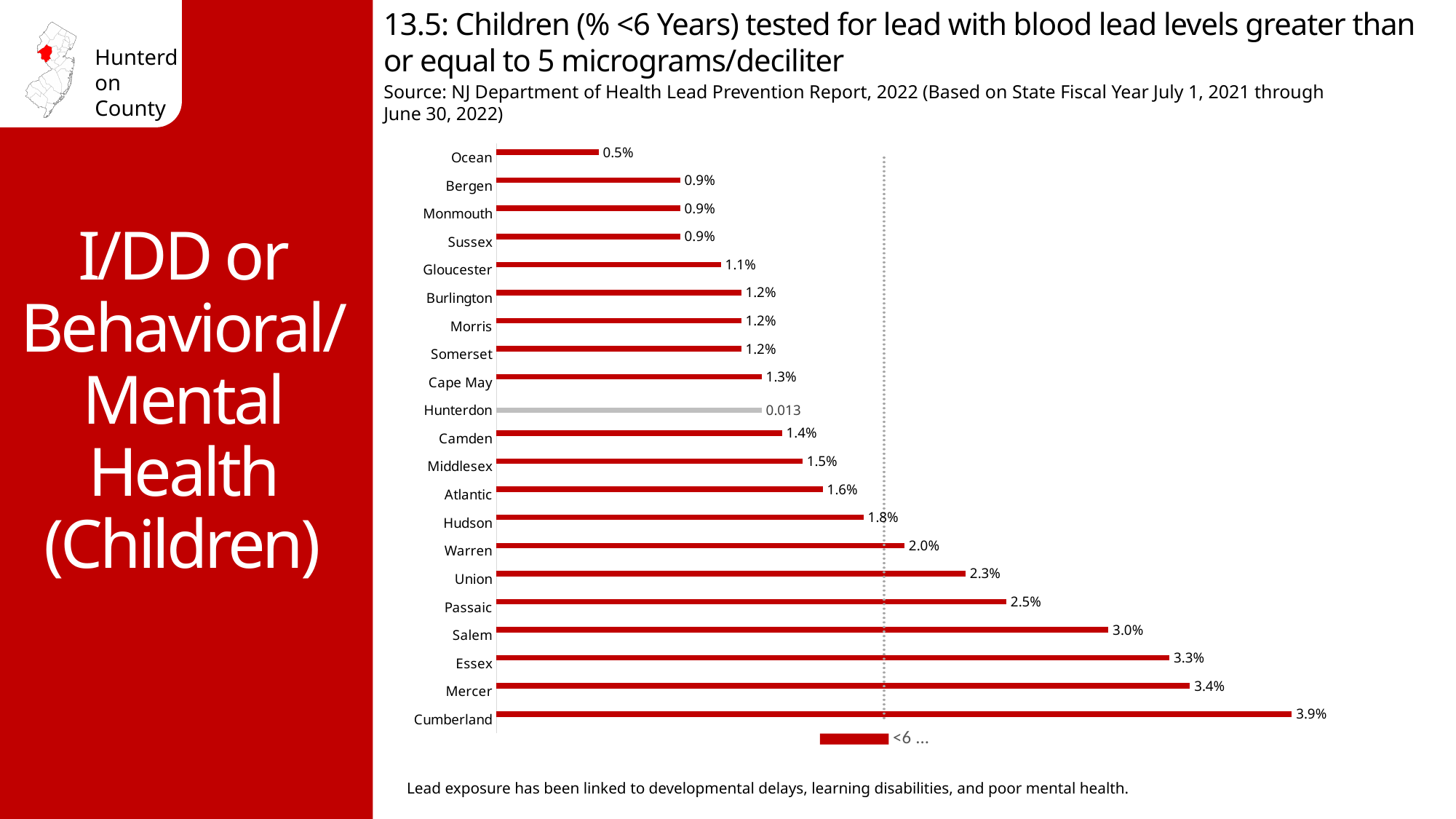
What colour is the Hunterdon bar? gray What is the value for Cumberland? 3.9% What is the value for Passaic? 2.5% Which has a larger value, Salem or Union? Salem What is the value for Ocean? 0.5% How many counties are shown in the chart? 21 Which county has the highest value? Cumberland What is the difference between the values for Warren and Hudson? 0.2% What is the difference between the values for Cumberland and Ocean? 3.4% Which county has the lowest value? Ocean What type of chart is shown on the slide? bar chart What value is labeled on the Hunterdon bar? 0.013